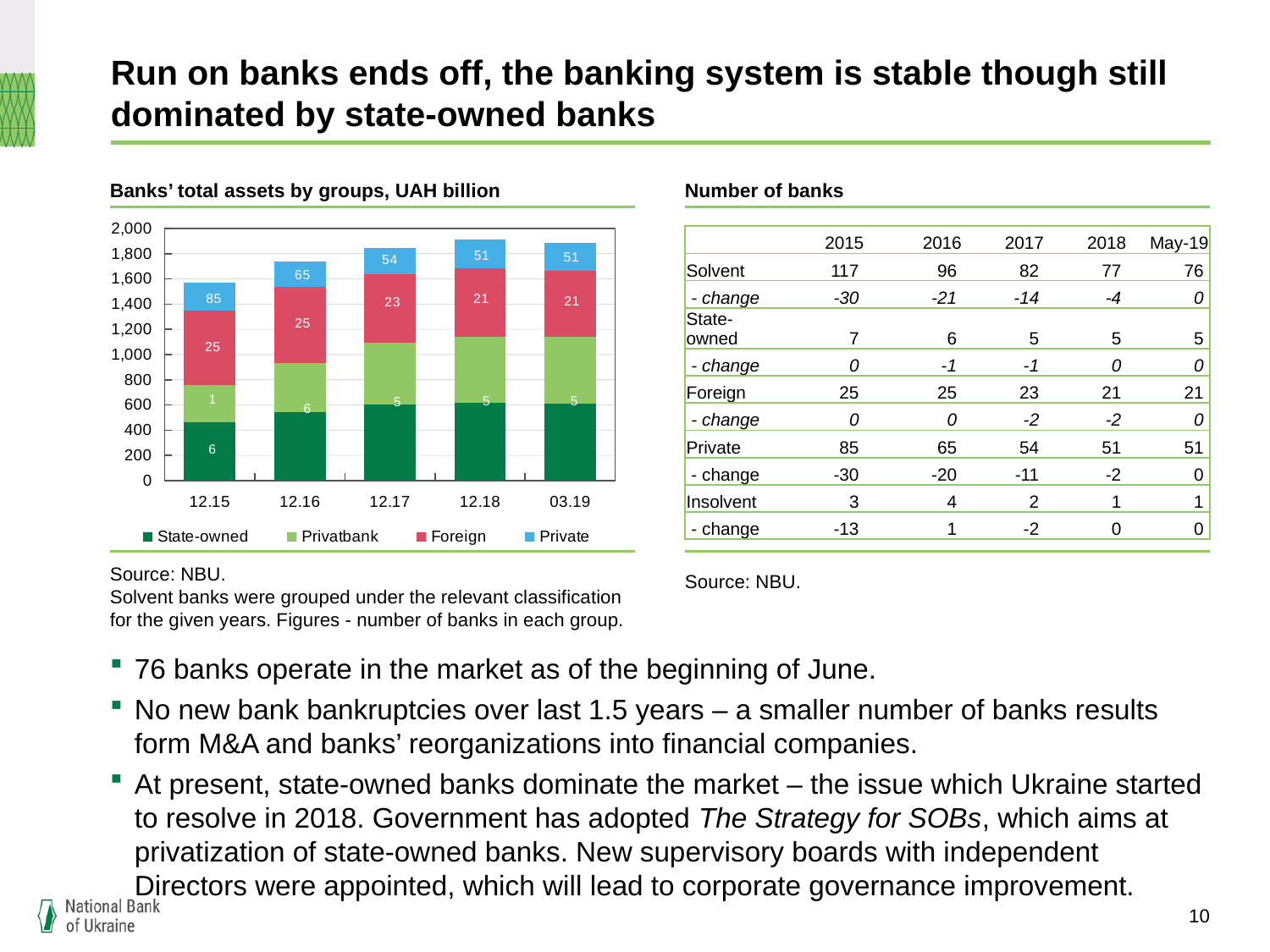
What kind of chart is shown under the title 'Banks' total assets by groups, UAH billion'? stacked bar chart In the 'Banks' total assets by groups' chart, what figure is printed on the Private segment for 12.15? 85 In the 'Banks' total assets by groups' chart, is the State-owned segment for 12.15 greater or less than 600? less In the 'Banks' total assets by groups' chart, which period has the lowest total bar? 12.15 In the 'Banks' total assets by groups' chart, do total assets rise or fall from 12.15 to 12.18? rise In the 'Banks' total assets by groups' chart, is the total bar for 12.16 greater or less than 1,800? less In the 'Banks' total assets by groups' chart, is the total bar for 12.18 greater or less than 1,800? greater In the 'Banks' total assets by groups' chart, what figure is printed on the Foreign segment for 12.17? 23 How many series does the legend of the 'Banks' total assets by groups' chart list? 4 How many periods are shown on the x axis of the 'Banks' total assets by groups' chart? 5 Which series in the 'Banks' total assets by groups' chart is shown in dark green? State-owned